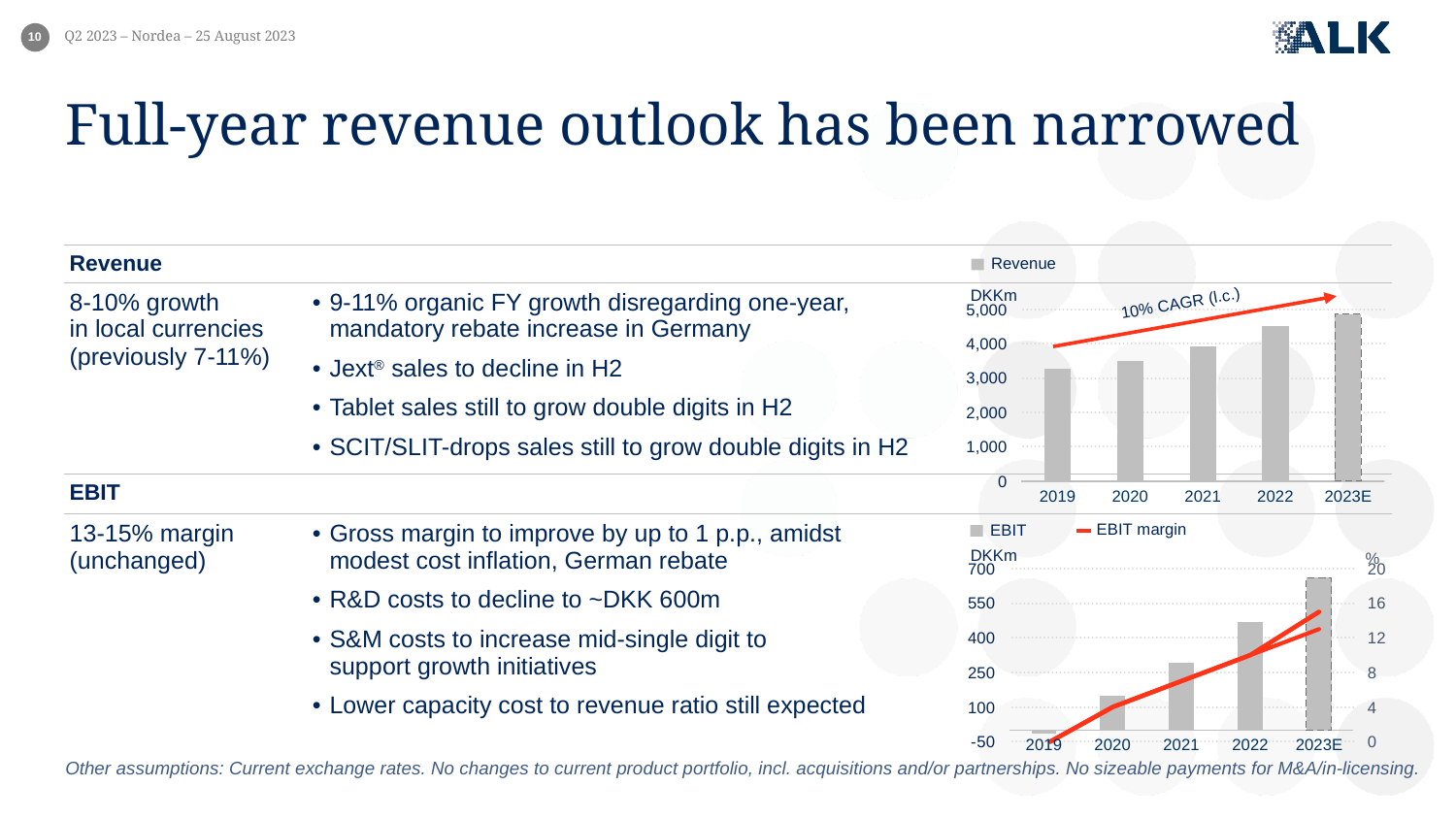
In the Revenue chart, how many years are shown on the x axis? 5 In the EBIT chart, how many series does the legend list? 2 What growth rate is written on the arrow annotation in the Revenue chart? 10% CAGR (l.c.) In the Revenue chart, do the revenue bars rise or fall from 2019 to 2023E? rise In the EBIT chart, which year has the highest EBIT bar? 2023E In the Revenue chart, is the value for 2019 greater or less than 4,000? less In the EBIT chart, is the EBIT value for 2023E greater or less than 550? greater In the Revenue chart, which year has the highest revenue bar? 2023E In the Revenue chart, is the value for 2022 greater or less than 4,000? greater In the EBIT chart, is the EBIT bar for 2022 larger or smaller than the EBIT bar for 2020? larger In the Revenue chart, which year has the lowest revenue bar? 2019